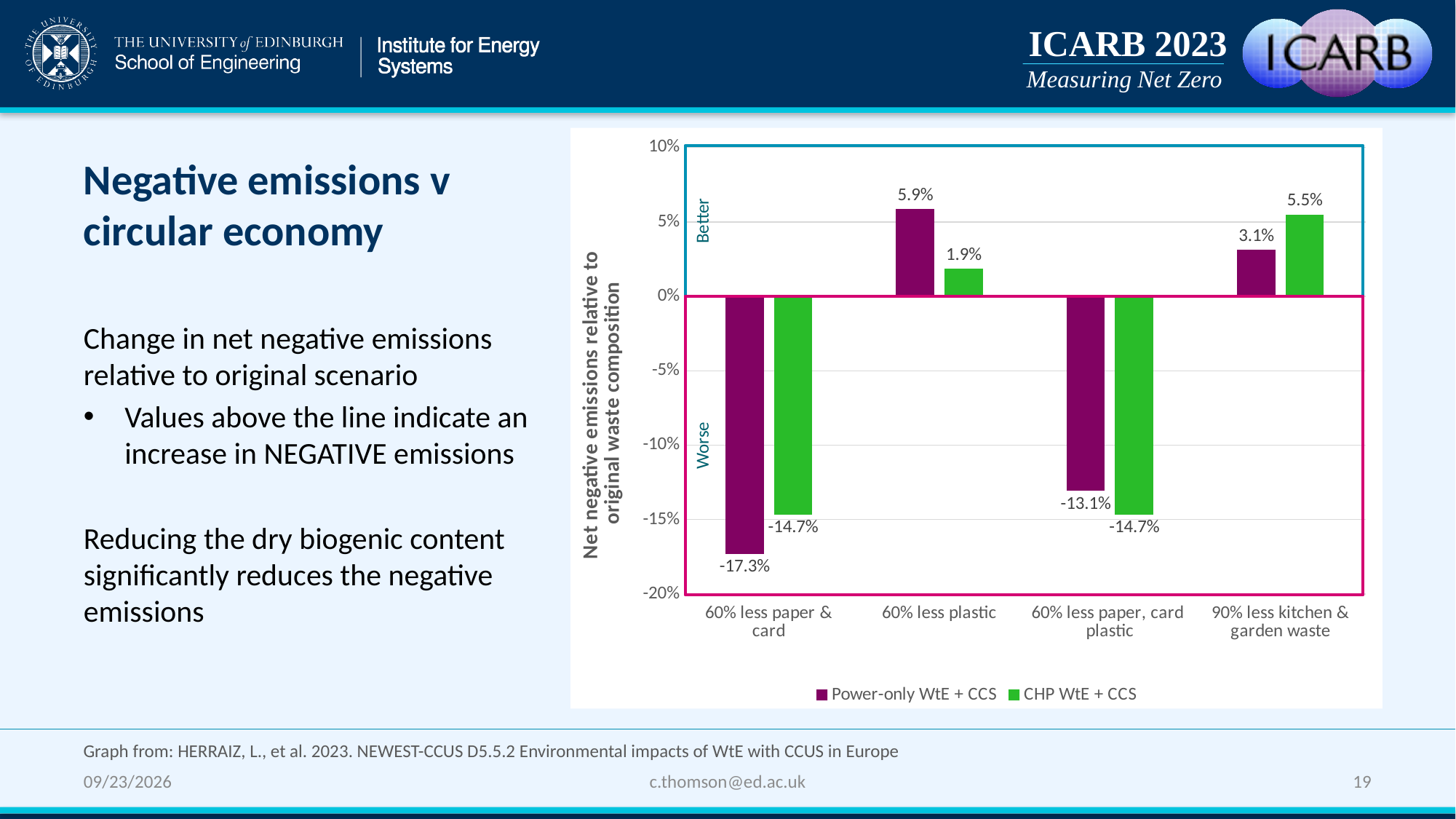
Which colour represents the CHP WtE + CCS series? Green How many waste composition scenarios are shown on the x axis? 4 In the '90% less kitchen & garden waste' scenario, which series has the larger value, Power-only WtE + CCS or CHP WtE + CCS? CHP WtE + CCS What is the difference between the Power-only WtE + CCS and CHP WtE + CCS values in the '60% less plastic' scenario? 4.0% What is the value for CHP WtE + CCS in the '60% less plastic' scenario? 1.9% What is the value for Power-only WtE + CCS in the '60% less paper & card' scenario? -17.3% What is the value for Power-only WtE + CCS in the '60% less paper, card plastic' scenario? -13.1% What kind of chart is shown on the slide? Bar chart Which scenario has the lowest value for Power-only WtE + CCS? 60% less paper & card How many series does the legend list? 2 What is the value for CHP WtE + CCS in the '90% less kitchen & garden waste' scenario? 5.5% Which scenario has the highest value for Power-only WtE + CCS? 60% less plastic